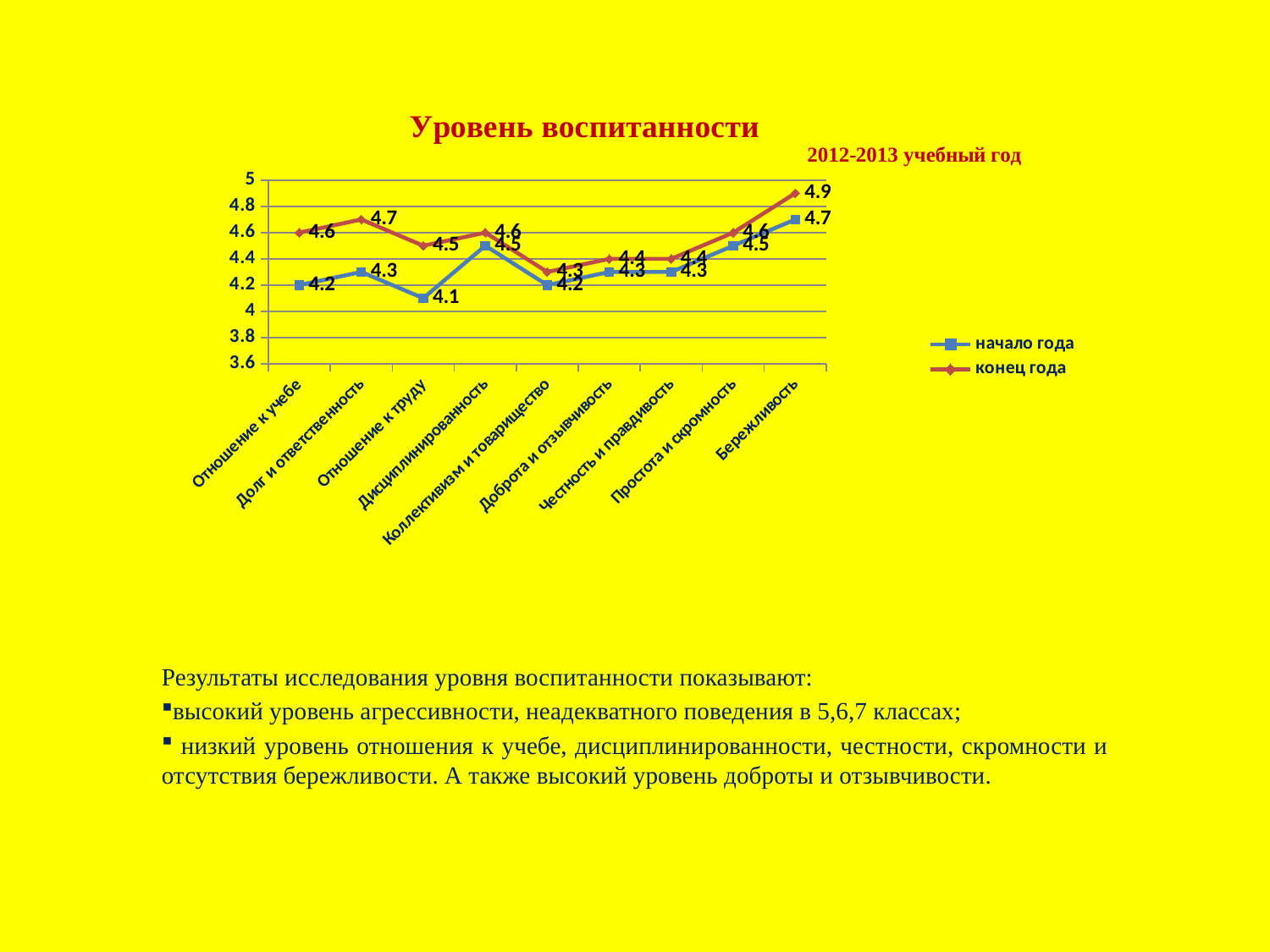
Which is larger for "Отношение к труду": the "начало года" value or the "конец года" value? конец года Which category has the lowest value in the "начало года" series? Отношение к труду What kind of chart is shown on the slide? line chart What is the difference between the "конец года" and "начало года" values for "Отношение к учебе"? 0.4 How many categories are plotted along the x axis? 9 Which category has the highest value in the "конец года" series? Бережливость What is the value for "Отношение к труду" in the "начало года" series? 4.1 How many series does the legend list? 2 What is the value for "Долг и ответственность" in the "конец года" series? 4.7 Is the "начало года" value for "Бережливость" greater or less than 4.6? greater What is the title of the chart? Уровень воспитанности What is the value for "Бережливость" in the "конец года" series? 4.9